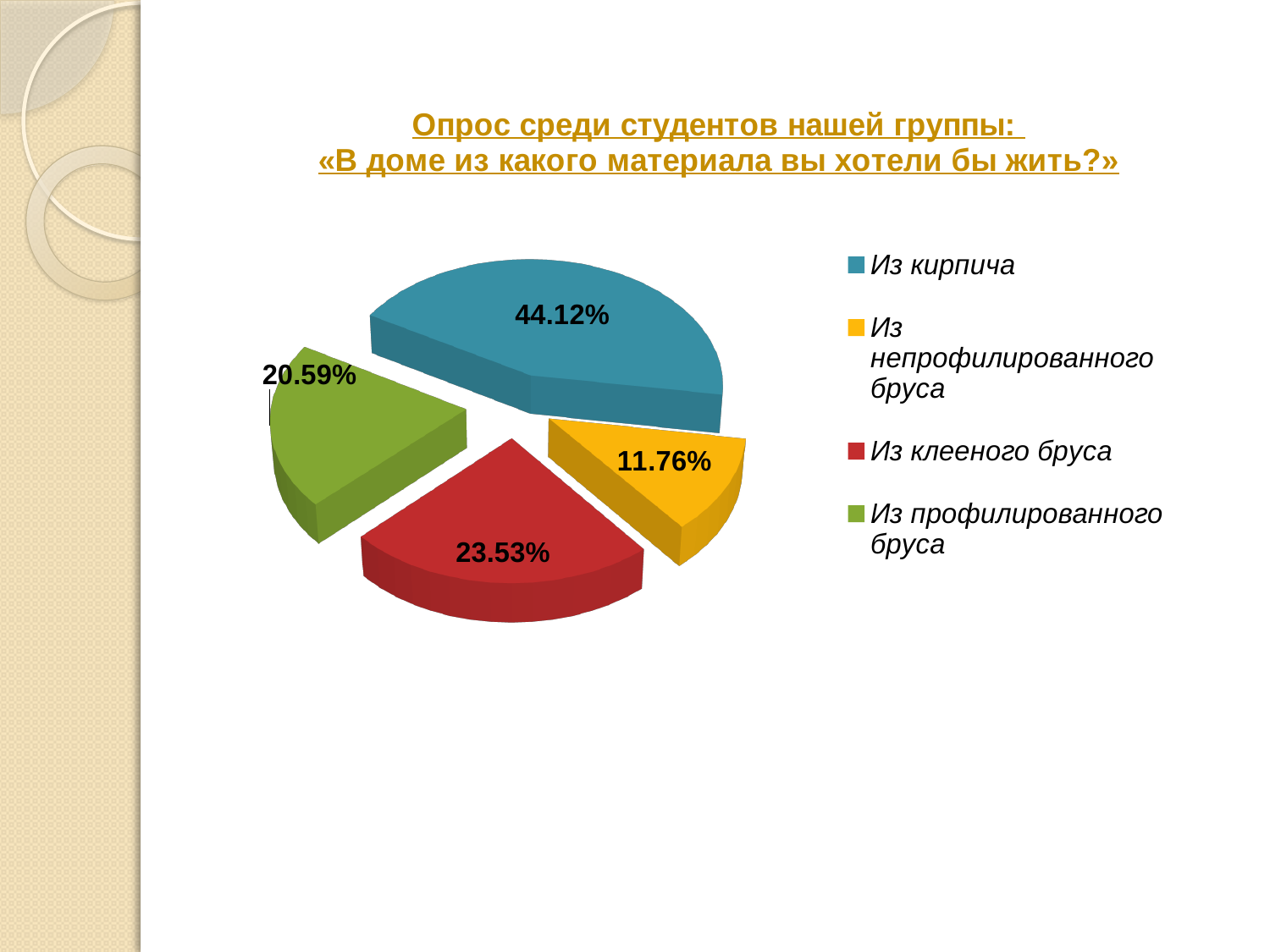
What share of students chose «Из кирпича»? 44.12% Which colour represents «Из клееного бруса» in the chart? Red What is the difference in percentage points between «Из клееного бруса» and «Из профилированного бруса»? 2.94 What share of students chose «Из профилированного бруса»? 20.59% Which material received the largest share of votes? Из кирпича Which material received the smallest share of votes? Из непрофилированного бруса What share of students chose «Из клееного бруса»? 23.53% Which has a larger share: «Из клееного бруса» or «Из профилированного бруса»? Из клееного бруса What share of students chose «Из непрофилированного бруса»? 11.76% How many categories (slices) does the pie chart have? 4 What is the difference in percentage points between «Из кирпича» and «Из непрофилированного бруса»? 32.36 What type of chart is shown on the slide? Pie chart